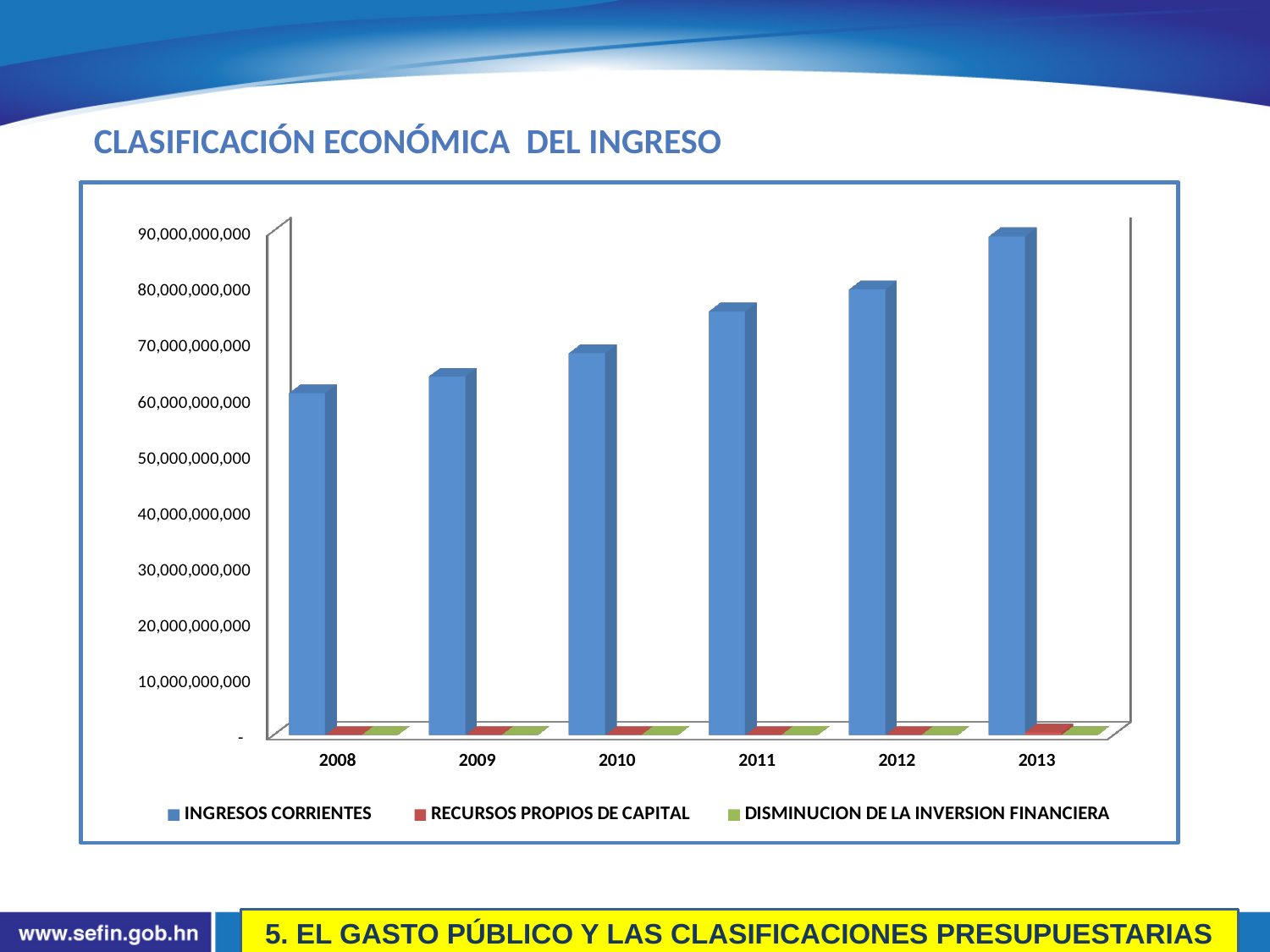
What is the title of the chart on the slide? CLASIFICACIÓN ECONÓMICA DEL INGRESO Which year has the highest value for INGRESOS CORRIENTES? 2013 Which year has the lowest value for INGRESOS CORRIENTES? 2008 How many series does the chart legend list? 3 Do the INGRESOS CORRIENTES values rise or fall from 2008 to 2013? rise Which year has the larger INGRESOS CORRIENTES value, 2009 or 2011? 2011 What kind of chart is shown on the slide? bar chart Which series is shown in blue in the chart legend? INGRESOS CORRIENTES How many years are shown on the x axis of the chart? 6 Is the INGRESOS CORRIENTES value for 2008 greater or less than 70,000,000,000? less Is the INGRESOS CORRIENTES value for 2011 greater or less than 70,000,000,000? greater Is the INGRESOS CORRIENTES value for 2013 greater or less than 80,000,000,000? greater